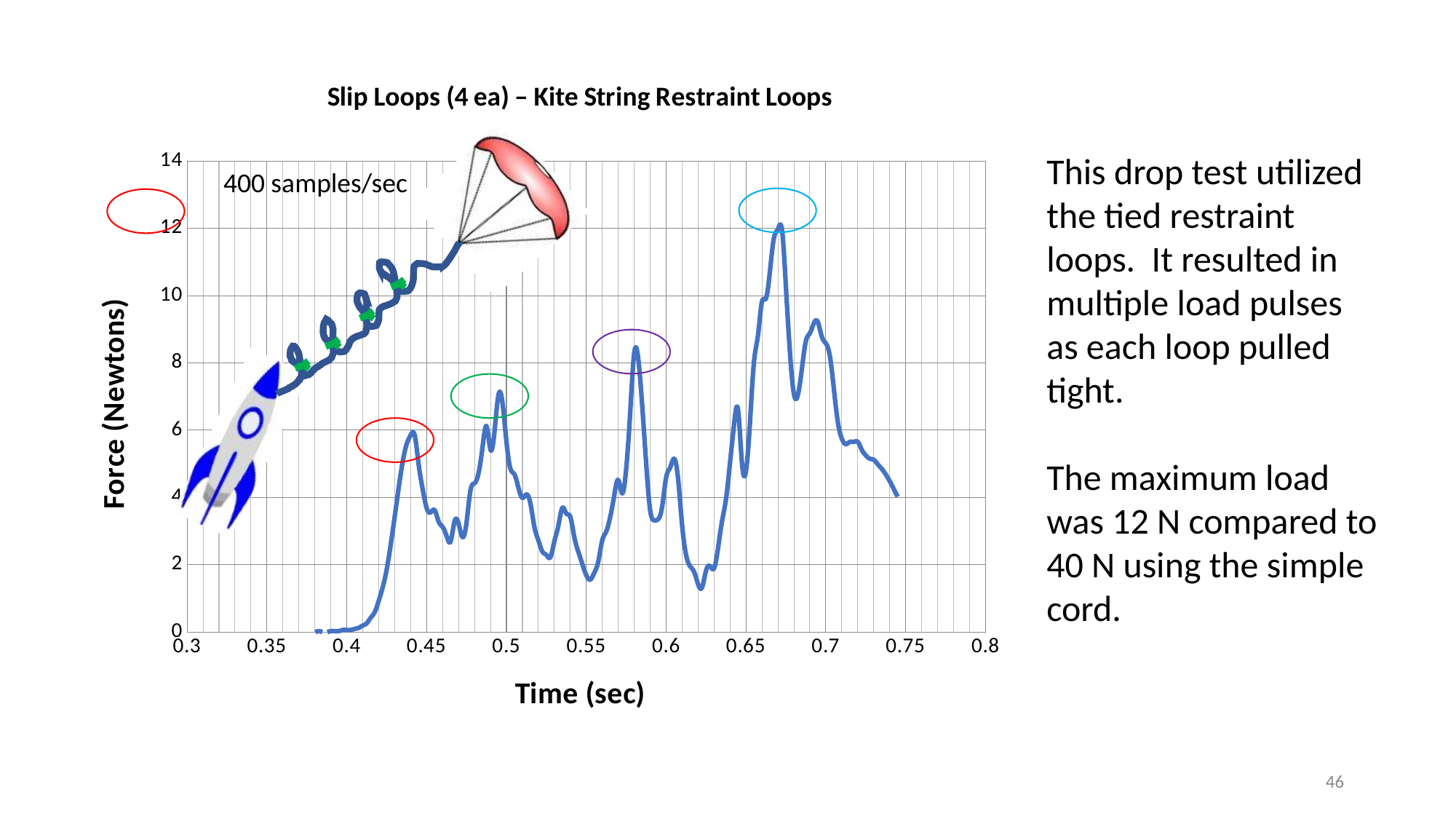
What is the title of the chart? Slip Loops (4 ea) – Kite String Restraint Loops Is the peak force near 0.5 sec greater or less than 6 Newtons? greater Between 0.4 sec and 0.44 sec, does the force rise or fall? rise Is the peak force near 0.58 sec greater or less than 6 Newtons? greater Which peak is higher: the one near 0.44 sec or the one near 0.67 sec? the one near 0.67 sec According to the slide, what was the maximum load recorded in this drop test? 12 N What kind of chart is shown on the slide? line chart Is the peak force near 0.67 sec greater or less than 10 Newtons? greater How many data series are plotted in the chart? 1 What is the label of the vertical axis of the chart? Force (Newtons)